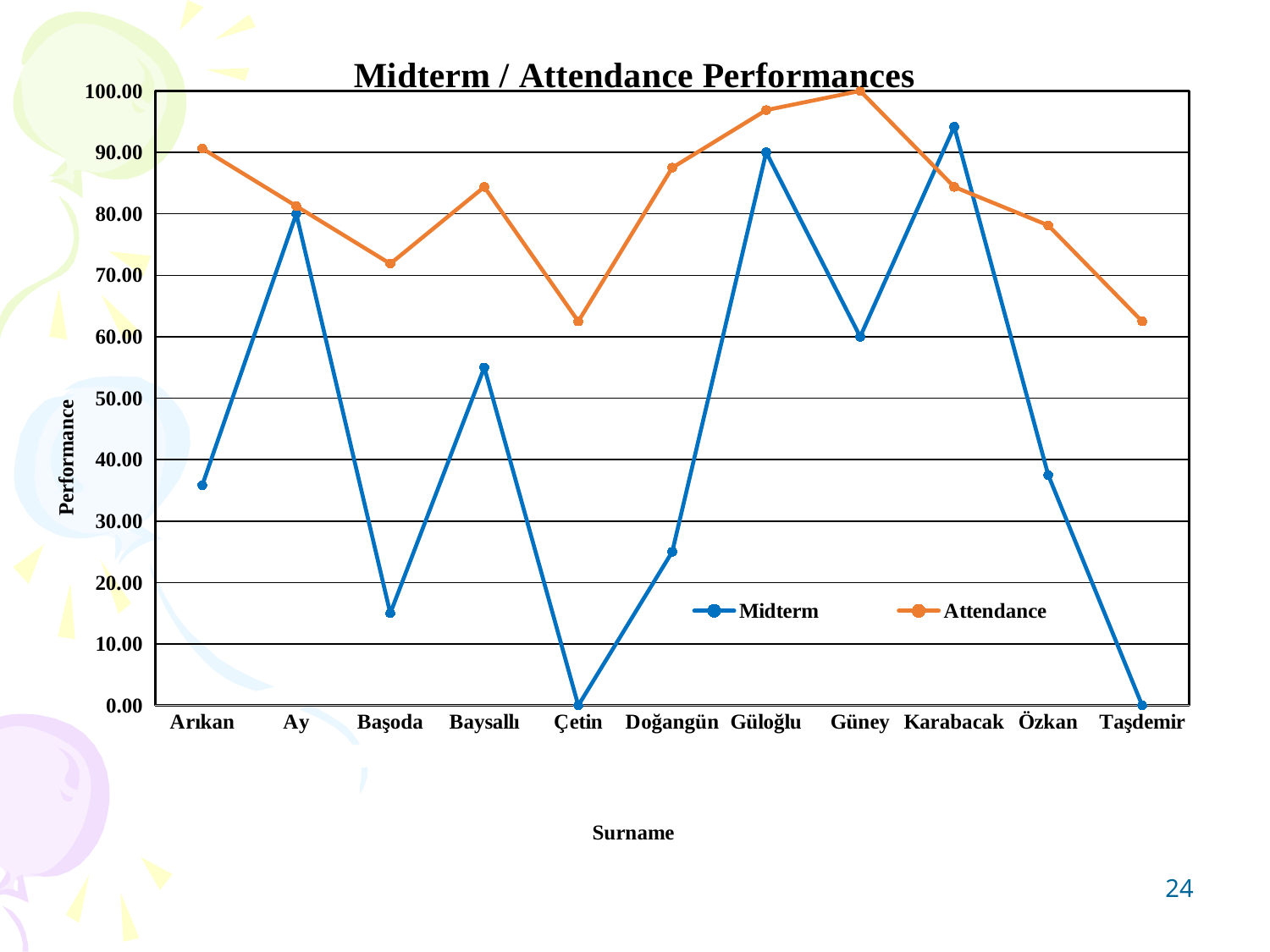
What is the Midterm value for Güney? 60.00 How many surnames are plotted along the x axis? 11 What is the Attendance value for Güney? 100.00 For Arıkan, which is larger, the Midterm value or the Attendance value? Attendance Is the Midterm value for Başoda greater or less than 20.00? less Is the Attendance value for Karabacak greater or less than 80.00? greater What is the title of the chart? Midterm / Attendance Performances What kind of chart is shown on the slide? line chart Which surname has the highest Attendance value? Güney How many series does the legend list? 2 Which surname has the highest Midterm value? Karabacak Does the Attendance line rise or fall from Güney to Taşdemir? fall